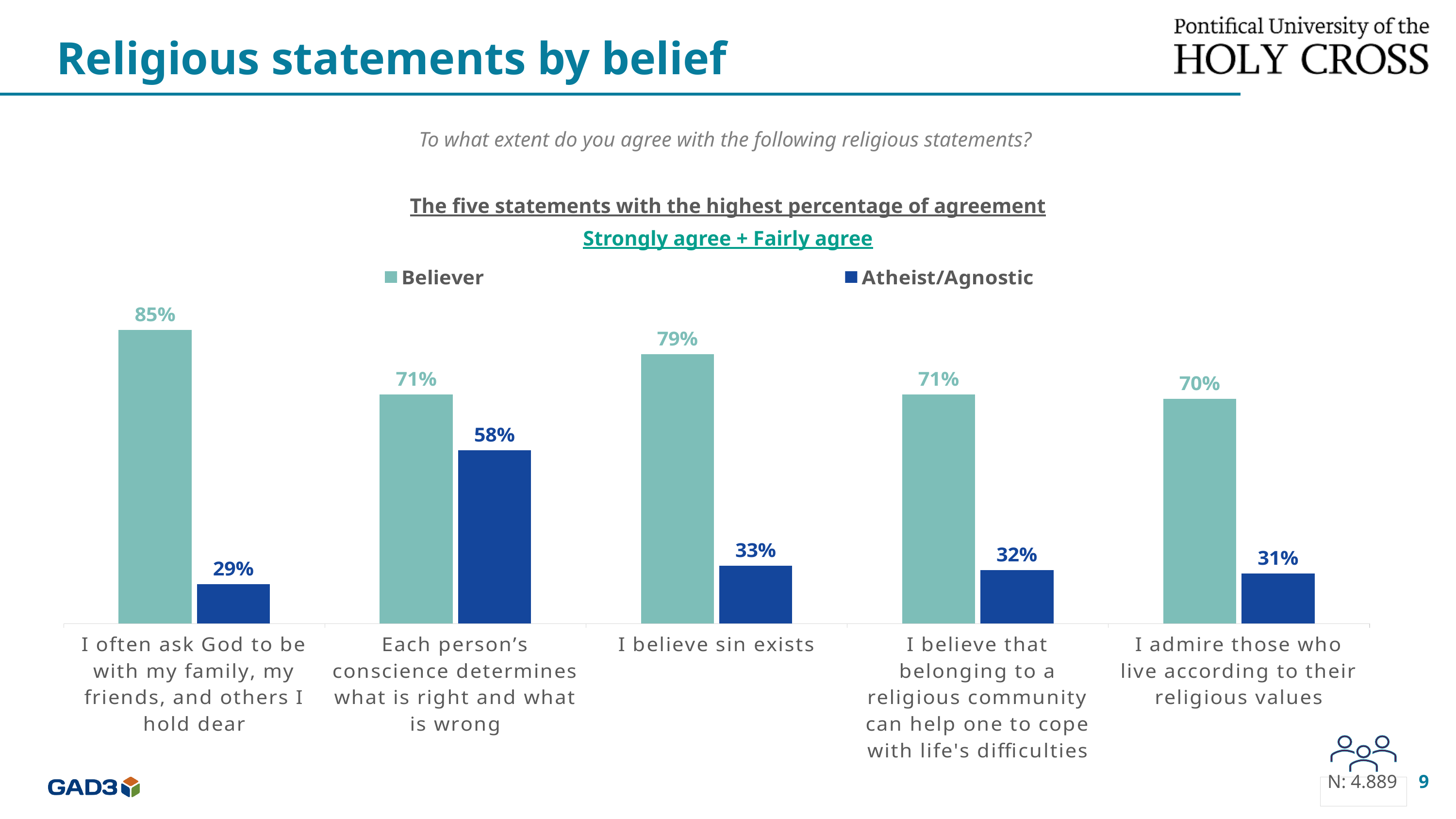
What percentage of Believers agree with the statement "I often ask God to be with my family, my friends, and others I hold dear"? 85% What kind of chart is shown on the slide? Bar chart Which series is shown in dark blue? Atheist/Agnostic Which is larger: the Atheist/Agnostic value for "I believe sin exists" or for "I admire those who live according to their religious values"? I believe sin exists What is the difference between the Believer and Atheist/Agnostic values for "I believe sin exists"? 46 percentage points What is the Atheist/Agnostic value for "I believe sin exists"? 33% How many series does the legend list? 2 What is the Believer value for "I admire those who live according to their religious values"? 70% Which statement has the lowest Atheist/Agnostic agreement? I often ask God to be with my family, my friends, and others I hold dear What percentage of Atheist/Agnostic respondents agree with "Each person's conscience determines what is right and what is wrong"? 58% Which statement has the highest Believer agreement? I often ask God to be with my family, my friends, and others I hold dear How many statements are shown in the chart? 5